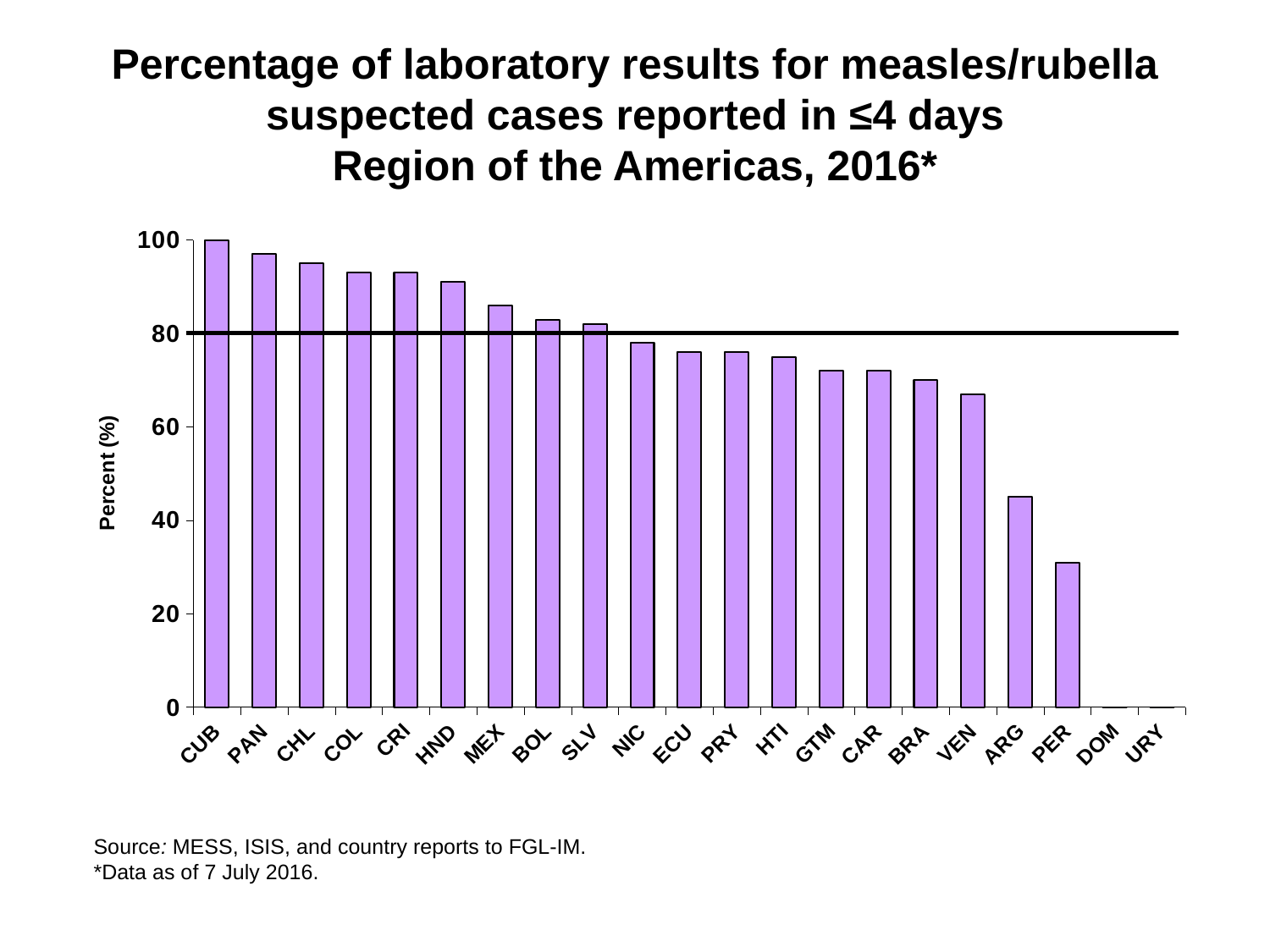
Which has the larger value, ARG or PER? ARG What is the label on the y axis of the chart? Percent (%) Is the value for VEN greater or less than 60? greater How many countries are shown on the x axis of the chart? 21 What kind of chart is shown on the slide? bar chart Is the value for ARG greater or less than 40? greater Is the value for HND greater or less than 80? greater What is the value for CUB? 100 Which country has the highest percentage of laboratory results reported in ≤4 days? CUB Do the values rise or fall moving from left to right along the x axis? fall